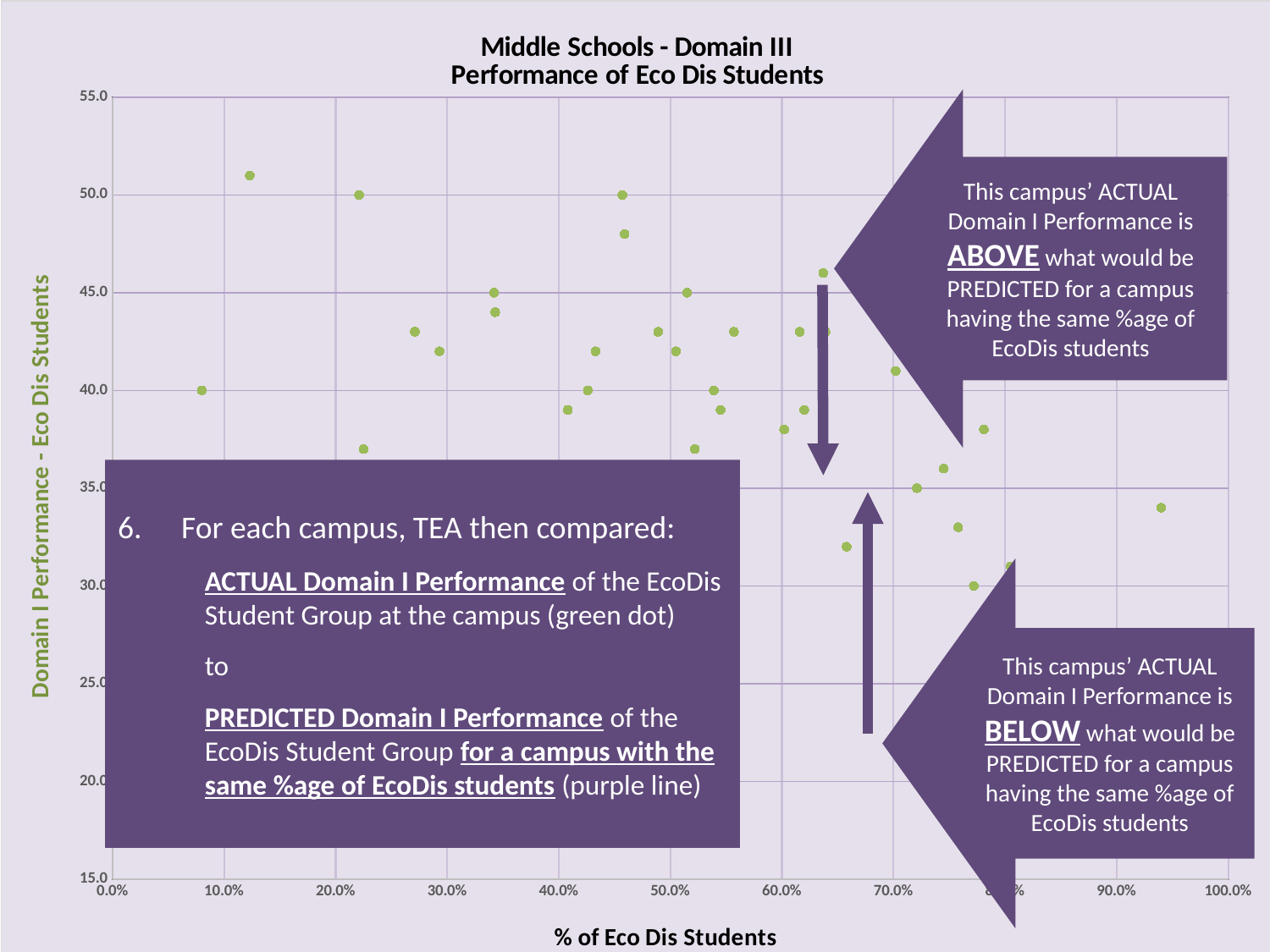
Is the rightmost plotted point in the chart (near 94% on the x axis) greater or less than 30.0 on the y axis? greater Is the highest plotted point in the chart greater or less than 55.0 on the y axis? less Is the rightmost plotted point in the chart (near 94% on the x axis) greater or less than 40.0 on the y axis? less What kind of chart is shown on the slide? Scatter chart What colour are the plotted data points in the chart? Green What is the title of the chart? Middle Schools - Domain III Performance of Eco Dis Students